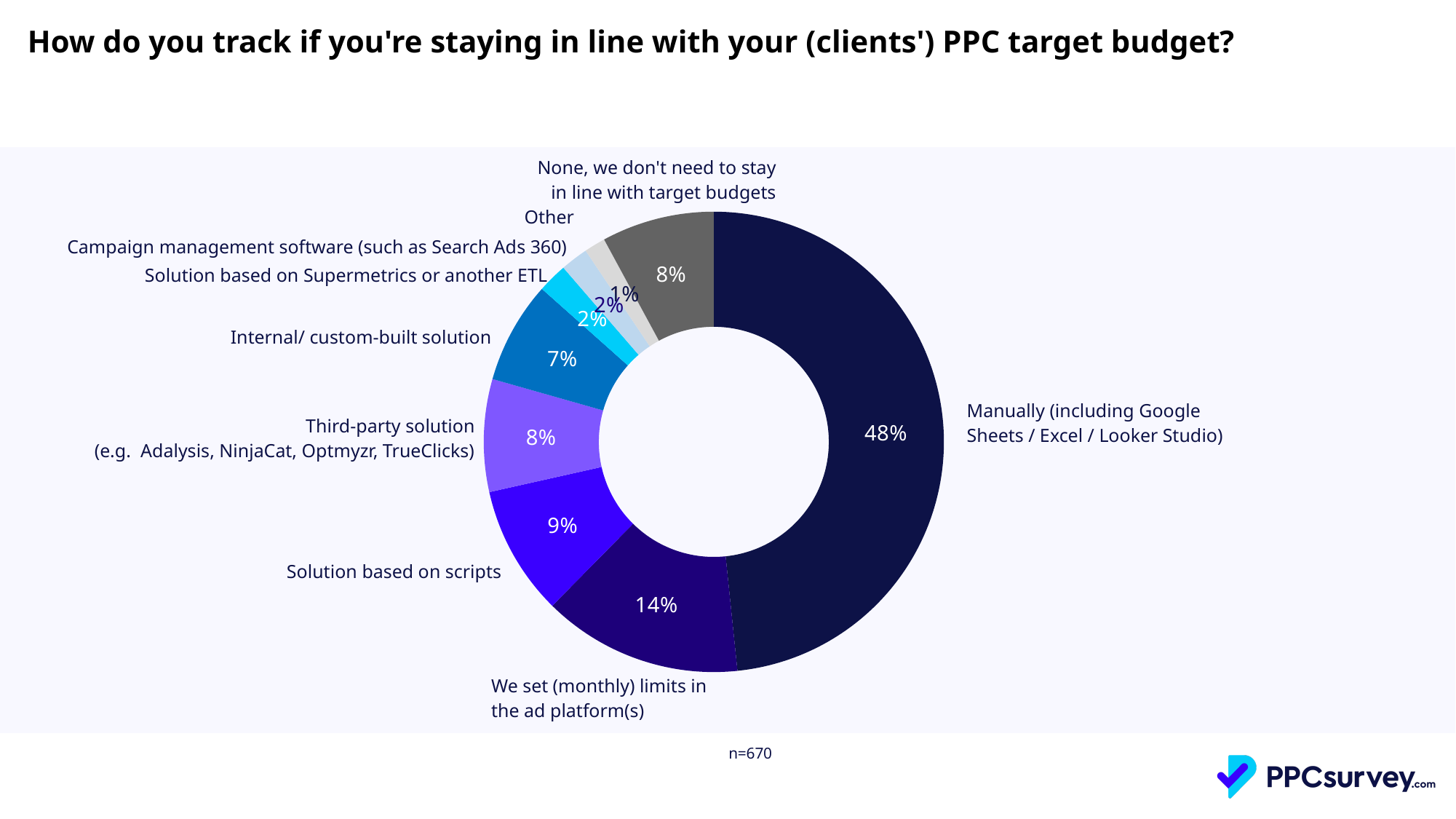
What kind of chart is shown on the slide? Pie chart (donut) What is the difference in percentage points between 'Manually' and 'We set (monthly) limits in the ad platform(s)'? 34 percentage points What percentage of respondents set (monthly) limits in the ad platform(s)? 14% What is the value for 'Solution based on scripts'? 9% What percentage use an internal/custom-built solution? 7% How many categories are shown in the chart? 9 Which category has the largest share of the pie? Manually (including Google Sheets / Excel / Looker Studio) Which is larger: 'Solution based on scripts' or 'Internal/ custom-built solution'? Solution based on scripts Which category has the smallest share of the pie? Other What share of respondents track their PPC target budget manually (including Google Sheets / Excel / Looker Studio)? 48% What is the value for 'None, we don't need to stay in line with target budgets'? 8% What is the sample size (n) shown below the chart? n=670